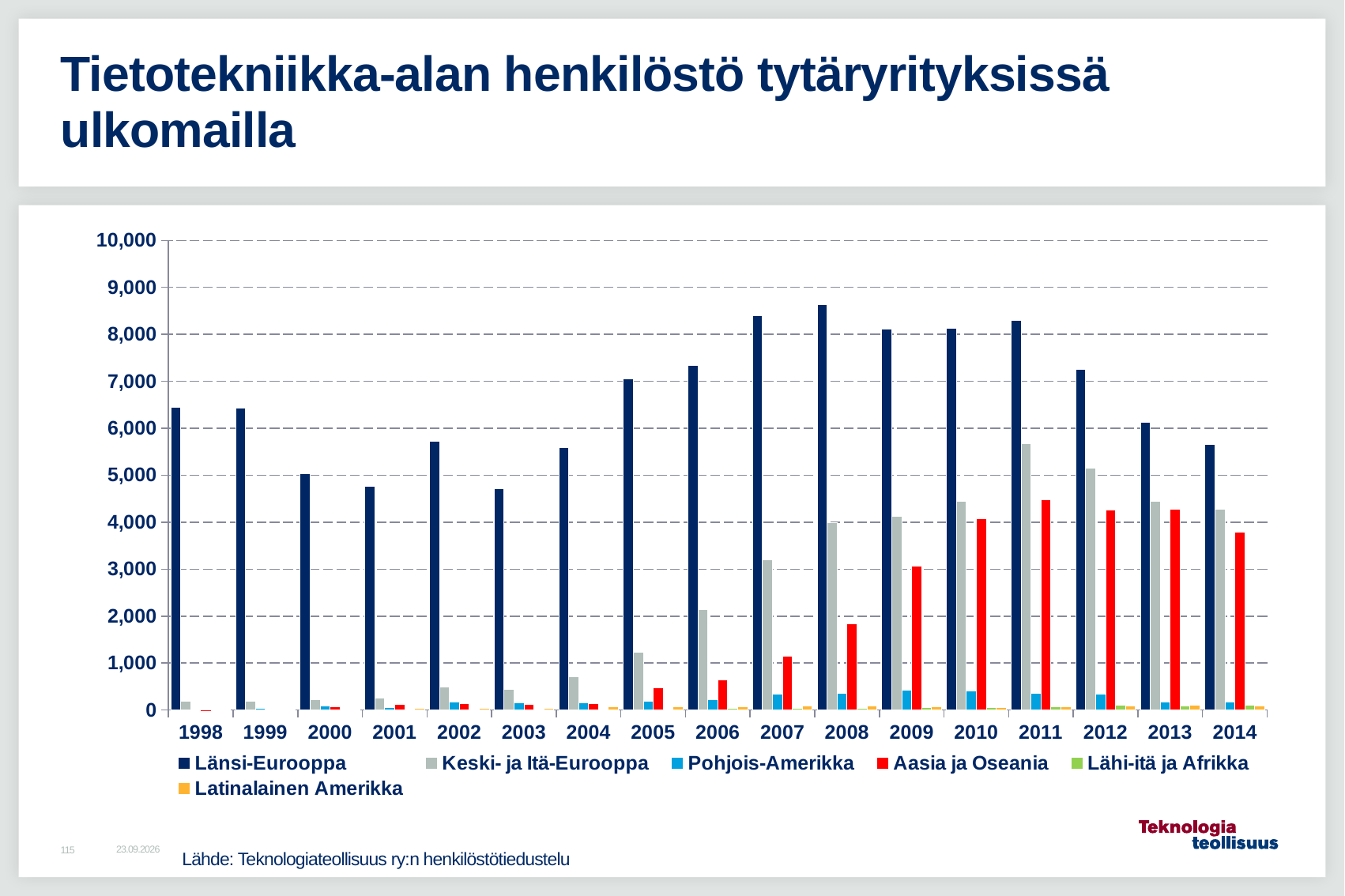
In which year is the value for Keski- ja Itä-Eurooppa highest? 2011 In which year is the value for Länsi-Eurooppa highest? 2008 How many series does the legend list? 6 How many years are shown on the x axis? 17 What colour represents Aasia ja Oseania in the chart? red In 2014, which is larger: Keski- ja Itä-Eurooppa or Aasia ja Oseania? Keski- ja Itä-Eurooppa Do the values for Länsi-Eurooppa rise or fall from 2011 to 2014? fall Is the value for Aasia ja Oseania in 2011 greater or less than 4,000? greater Is the value for Länsi-Eurooppa in 2014 greater or less than 6,000? less Is the value for Keski- ja Itä-Eurooppa in 2008 greater or less than 3,000? greater For Länsi-Eurooppa, which year has the larger value: 2003 or 2005? 2005 What kind of chart is shown on the slide? bar chart